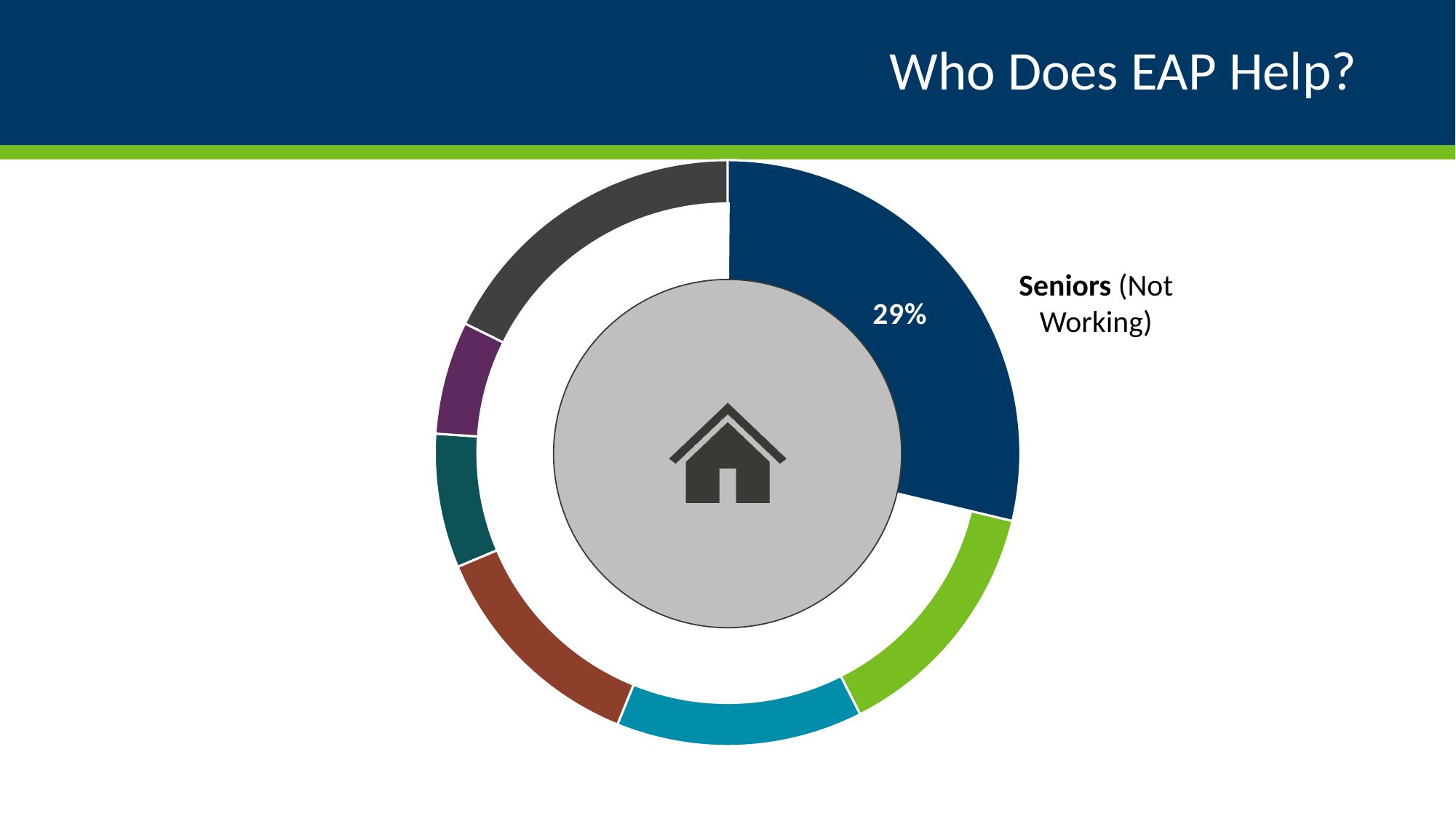
What percentage is shown for the Seniors (Not Working) segment? 29% What is the title of the slide containing the chart? Who Does EAP Help? What kind of chart is shown on the slide? Pie chart (donut) What share of the whole does the Seniors (Not Working) slice represent? 29% Which segment of the chart is the largest? Seniors (Not Working) What colour is the Seniors (Not Working) segment? Dark blue How many segments does the donut chart have? 7 How many segments of the chart have a printed data label? 1